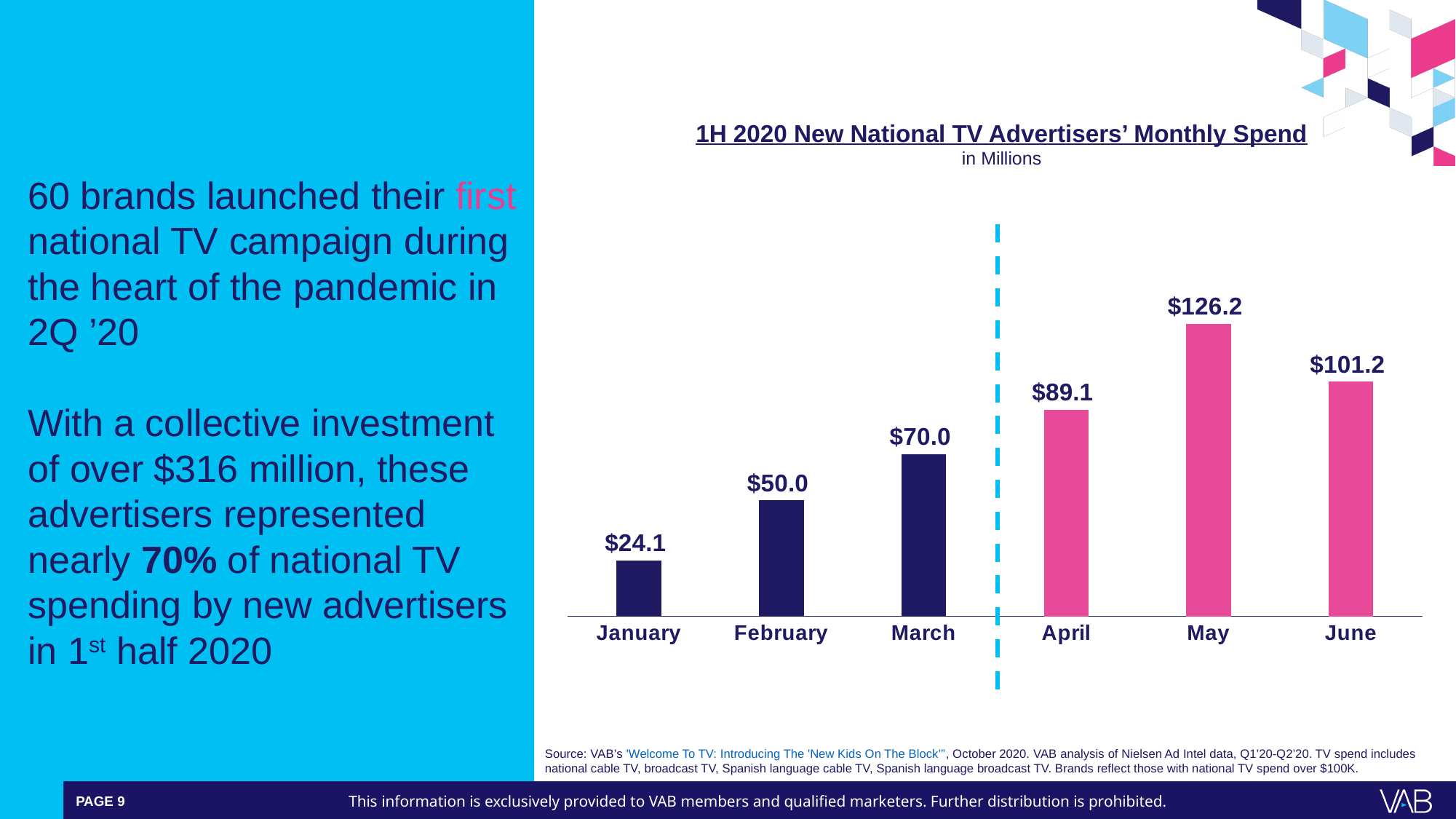
Which month has the lowest spend? January What kind of chart is shown on the slide? Bar chart What is the difference between the spend in March and the spend in February? $20.0 What is the monthly spend for May? $126.2 Which is larger, the spend in April or the spend in June? June What is the monthly spend for January? $24.1 What is the difference between the spend in May and the spend in June? $25.0 Do the values rise or fall from January to May? Rise What is the title of the chart? 1H 2020 New National TV Advertisers' Monthly Spend Which month has the highest spend? May What is the monthly spend for April? $89.1 How many months are shown on the chart? 6